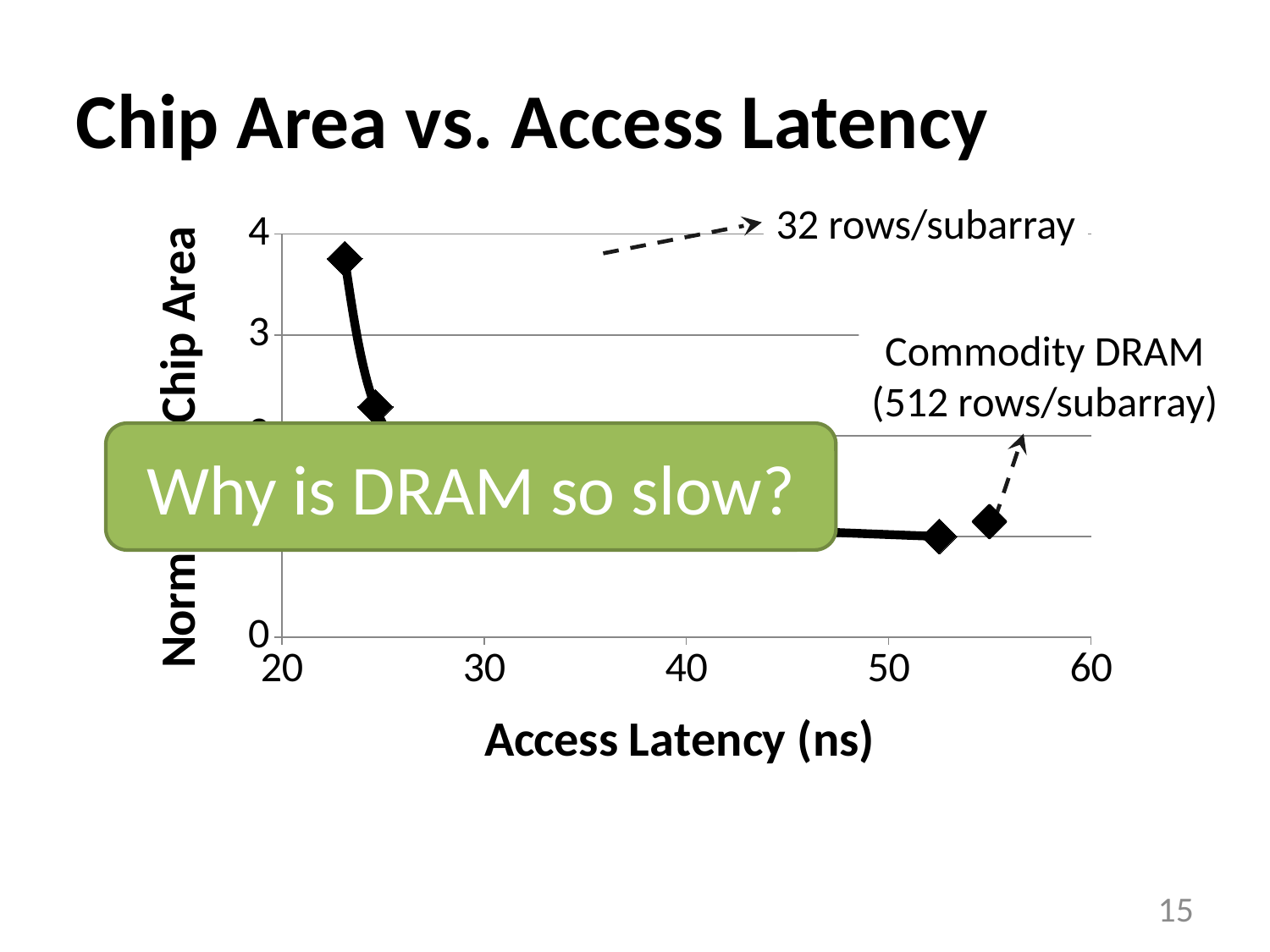
Is the access latency for Commodity DRAM (512 rows/subarray) greater or less than 50 ns? greater What is the label of the x axis? Access Latency (ns) Overall, does normalized chip area rise or fall as access latency increases along the x axis? fall Which has the higher access latency, 32 rows/subarray or Commodity DRAM (512 rows/subarray)? Commodity DRAM (512 rows/subarray) Is the normalized chip area for the 32 rows/subarray point greater or less than 3? greater What is the title of the chart? Chip Area vs. Access Latency Which point on the chart has the highest normalized chip area? 32 rows/subarray Which has the larger normalized chip area, 32 rows/subarray or Commodity DRAM (512 rows/subarray)? 32 rows/subarray What kind of chart is shown on the slide? line chart Is the normalized chip area for Commodity DRAM (512 rows/subarray) greater or less than 2? less